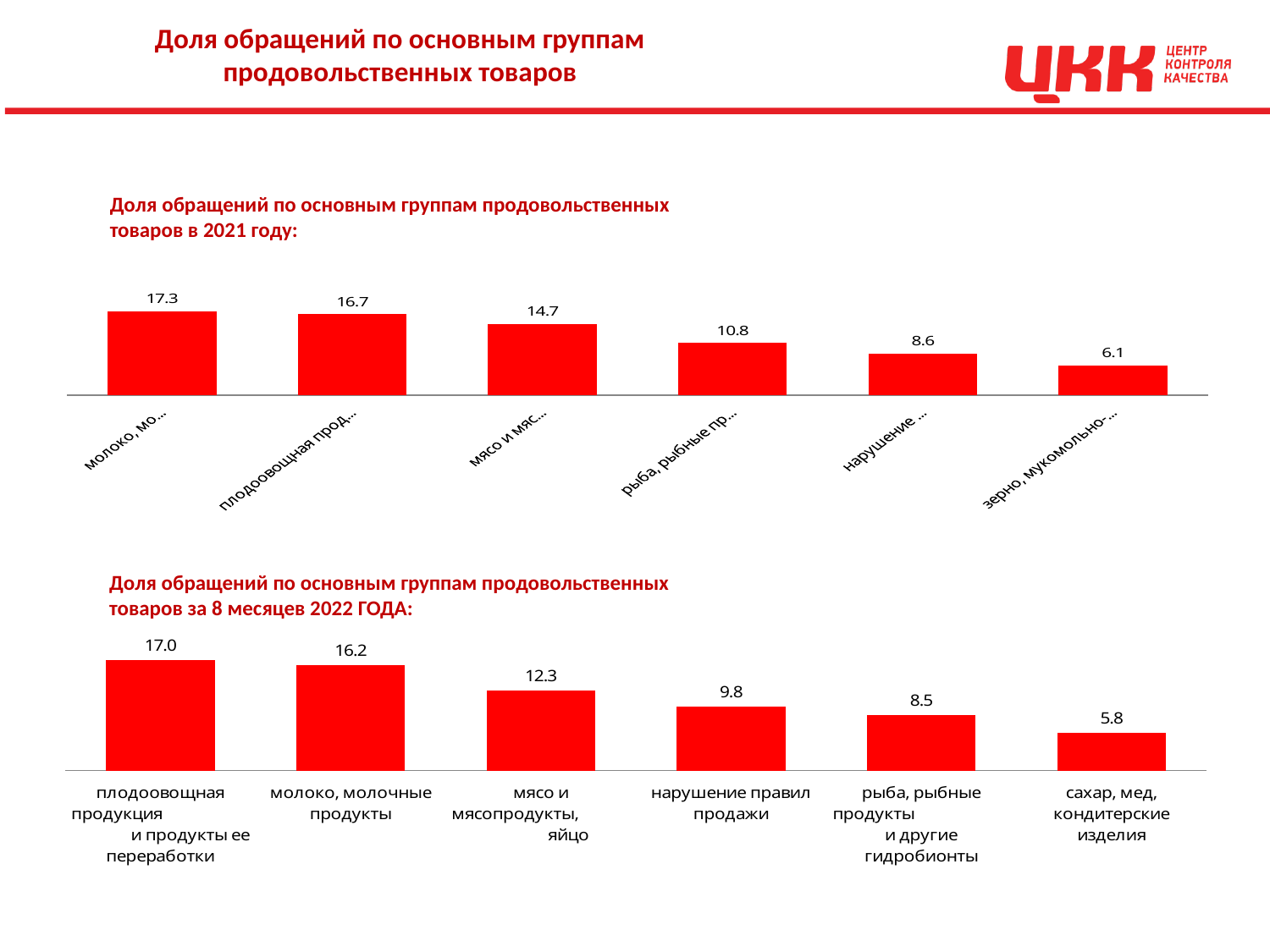
On the 2021 chart (top), how many bars are plotted? 6 On the 2022 chart (bottom), what is the difference between "молоко, молочные продукты" and "мясо и мясопродукты, яйцо"? 3.9 What type of chart is used on the bottom of the slide (8 months of 2022)? Bar chart On the 2022 chart (bottom), what is the value for "плодоовощная продукция и продукты ее переработки"? 17.0 On the 2021 chart (top), what is the difference between the first bar (17.3) and the second bar (16.7)? 0.6 On the 2021 chart (top), what is the value of the first bar, labelled "молоко, мо..."? 17.3 On the 2021 chart (top), what is the value of the bar labelled "рыба, рыбные пр..."? 10.8 On the 2022 chart (bottom), which category has the lowest value? сахар, мед, кондитерские изделия On the 2022 chart (bottom), which is larger: "мясо и мясопродукты, яйцо" or "рыба, рыбные продукты и другие гидробионты"? мясо и мясопродукты, яйцо On the 2022 chart (bottom), what is the value for "нарушение правил продажи"? 9.8 On the 2022 chart (bottom), which category has the highest value? плодоовощная продукция и продукты ее переработки On the 2021 chart (top), which bar is the lowest? зерно, мукомольно-... (6.1)